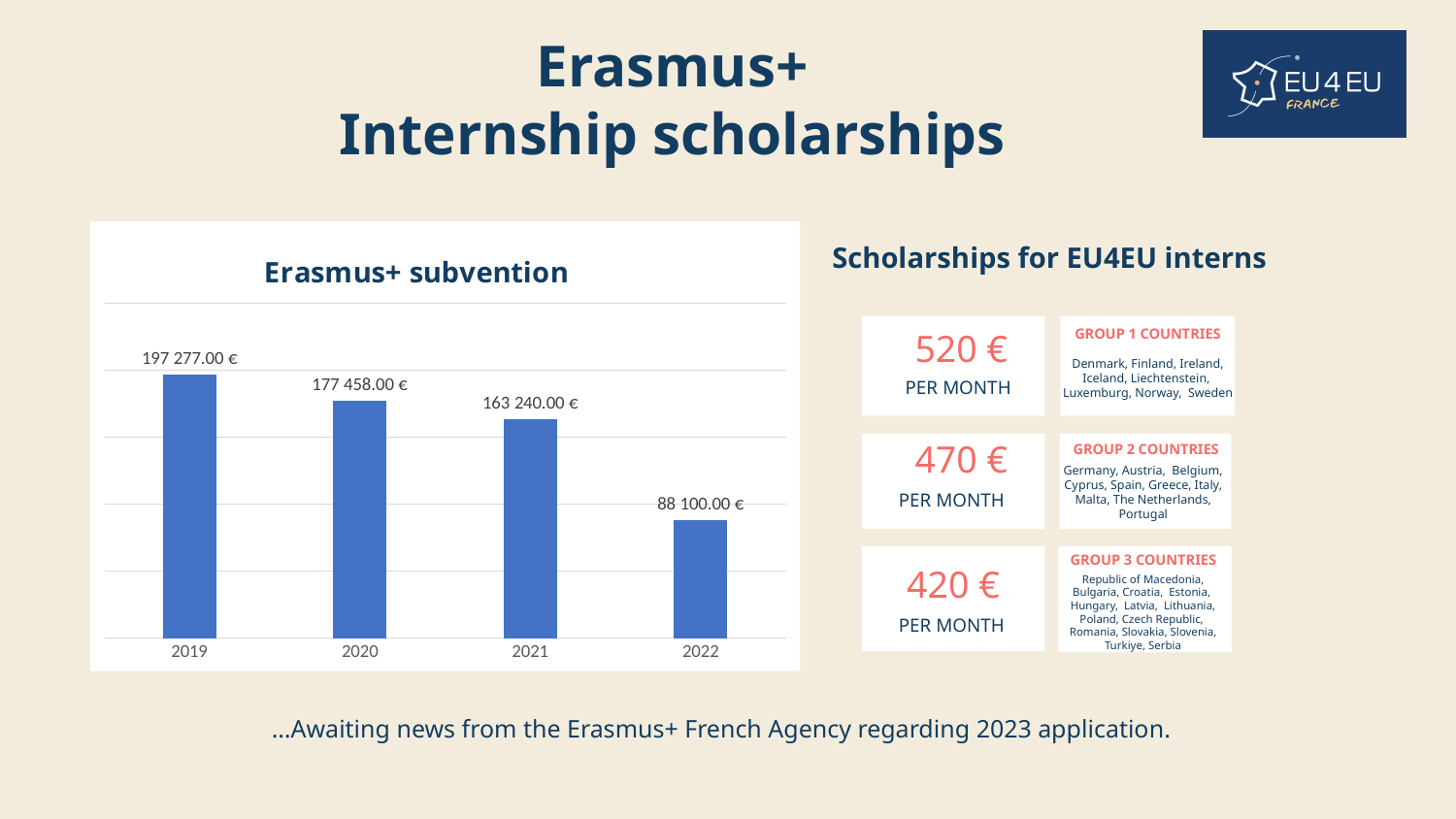
What kind of chart is the Erasmus+ subvention chart? Bar chart How many years are shown in the Erasmus+ subvention chart? 4 Which year has the highest Erasmus+ subvention? 2019 Do the values in the Erasmus+ subvention chart rise or fall from 2019 to 2022? Fall What is the difference between the Erasmus+ subvention in 2019 and in 2020? 19 819.00 € Which year has a larger Erasmus+ subvention, 2020 or 2021? 2020 What is the value for 2022 in the Erasmus+ subvention chart? 88 100.00 € What is the value for 2019 in the Erasmus+ subvention chart? 197 277.00 € What is the difference between the Erasmus+ subvention in 2021 and in 2022? 75 140.00 € What is the value for 2021 in the Erasmus+ subvention chart? 163 240.00 € What is the value for 2020 in the Erasmus+ subvention chart? 177 458.00 € Which year has the lowest Erasmus+ subvention? 2022